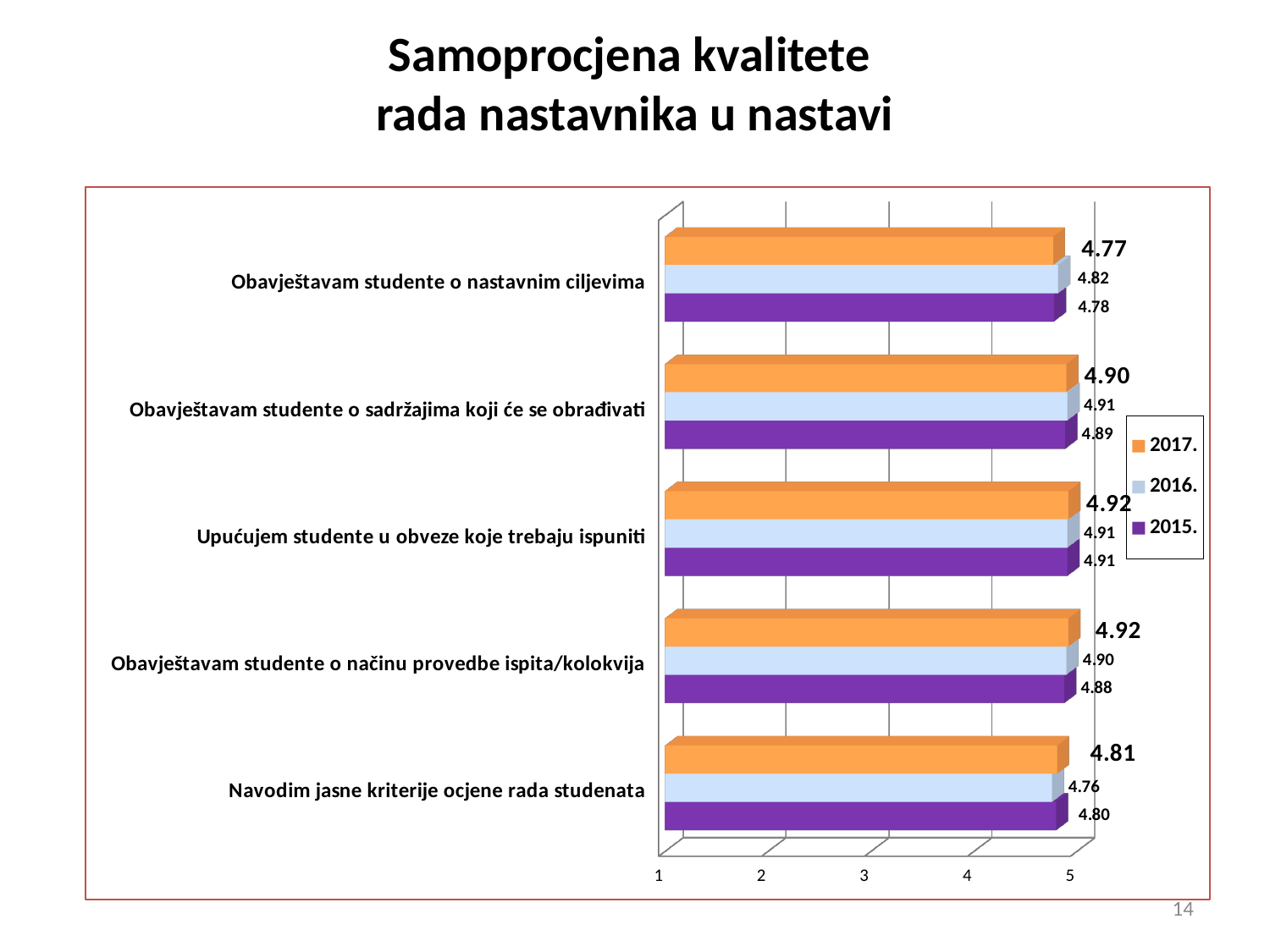
How many categories are shown on the chart? 5 How many series does the legend list? 3 For "Navodim jasne kriterije ocjene rada studenata", which is larger: the 2017. value or the 2016. value? 2017. What is the 2016. value for "Navodim jasne kriterije ocjene rada studenata"? 4.76 Which category has the lowest 2016. value? Navodim jasne kriterije ocjene rada studenata What is the 2016. value for "Obavještavam studente o sadržajima koji će se obrađivati"? 4.91 What is the difference between the 2016. and 2017. values for "Obavještavam studente o nastavnim ciljevima"? 0.05 Which category has the lowest 2017. value? Obavještavam studente o nastavnim ciljevima Which colour represents the 2015. series in the legend? Purple What is the 2015. value for "Obavještavam studente o načinu provedbe ispita/kolokvija"? 4.88 What is the 2017. value for "Obavještavam studente o nastavnim ciljevima"? 4.77 What type of chart is shown on the slide? Bar chart